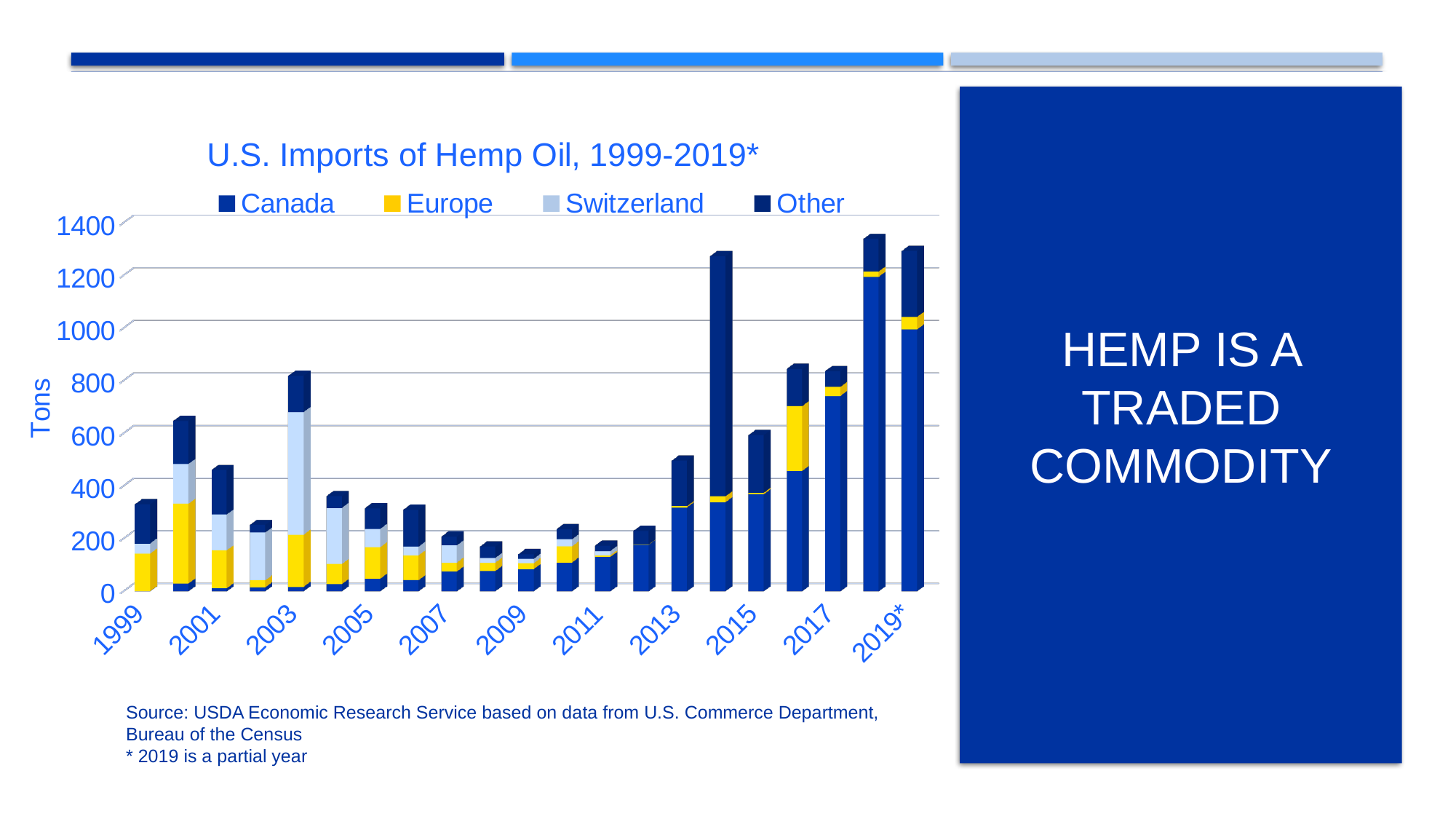
Is the total value for 2009 greater or less than 200? less Do the total bar heights rise or fall from 2005 to 2009? fall Which year has the lowest total imports on the chart? 2009 How many series does the chart legend list? 4 Is the total value for 2003 greater or less than 600? greater What type of chart is shown on the slide? Stacked bar chart Is the total value for 2018 greater or less than 1200? greater What is the title of the chart? U.S. Imports of Hemp Oil, 1999-2019* What is the label on the vertical axis of the chart? Tons How many years (bars) are plotted on the chart? 21 Which year has the larger total bar, 2003 or 2004? 2003